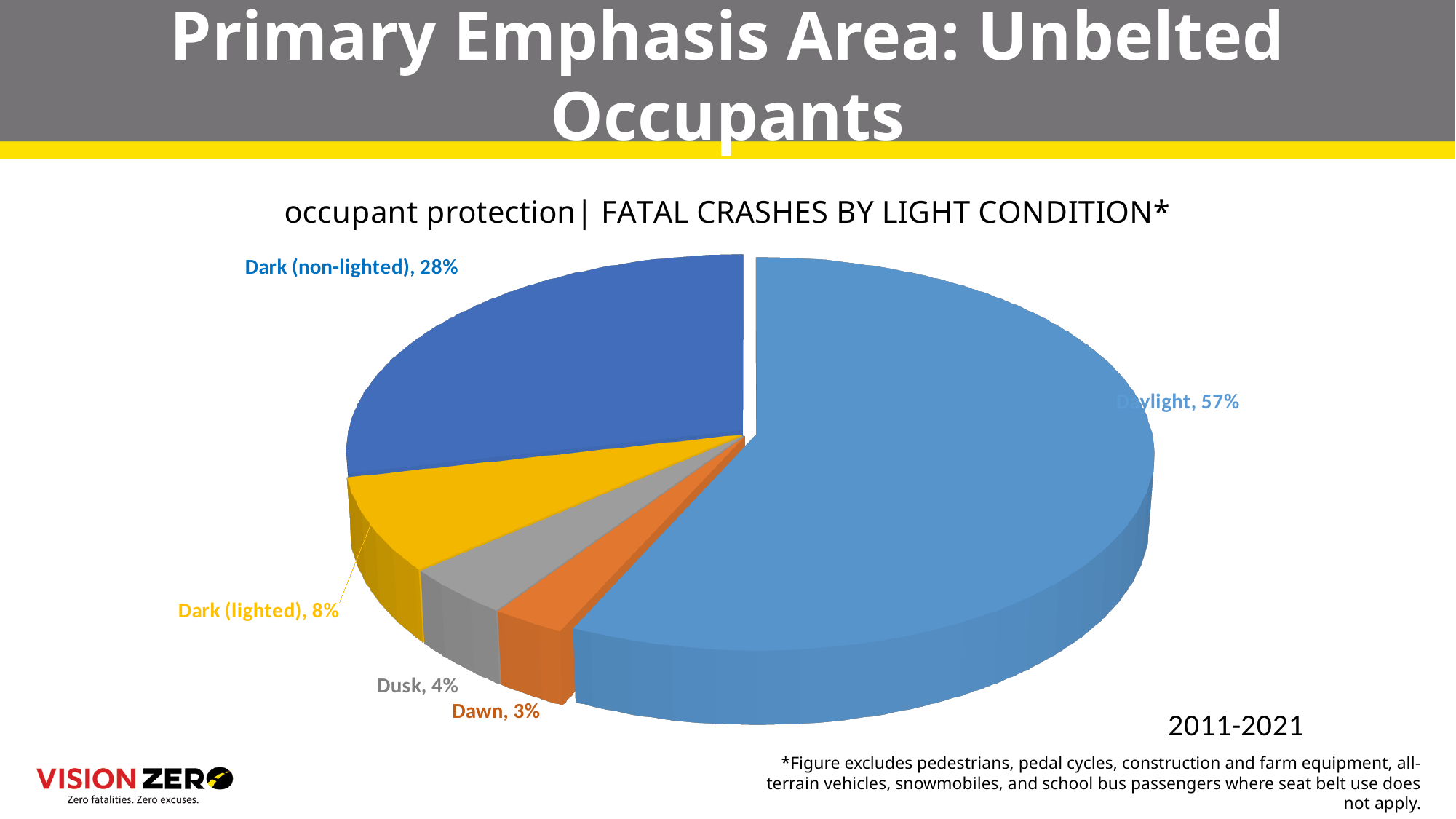
Which is larger, the share for Dusk or the share for Dark (lighted)? Dark (lighted) What share of fatal crashes occurred in daylight? 57% Which light condition accounts for the largest share of fatal crashes? Daylight What year range does the chart cover? 2011-2021 What type of chart is shown on the slide? Pie chart How many percentage points larger is the Daylight share than the Dark (non-lighted) share? 29 What share of fatal crashes occurred at dawn? 3% What share of fatal crashes occurred at dusk? 4% Which light condition accounts for the smallest share of fatal crashes? Dawn What share of fatal crashes occurred in dark (lighted) conditions? 8% How many light condition categories are shown in the pie chart? 5 What share of fatal crashes occurred in dark (non-lighted) conditions? 28%